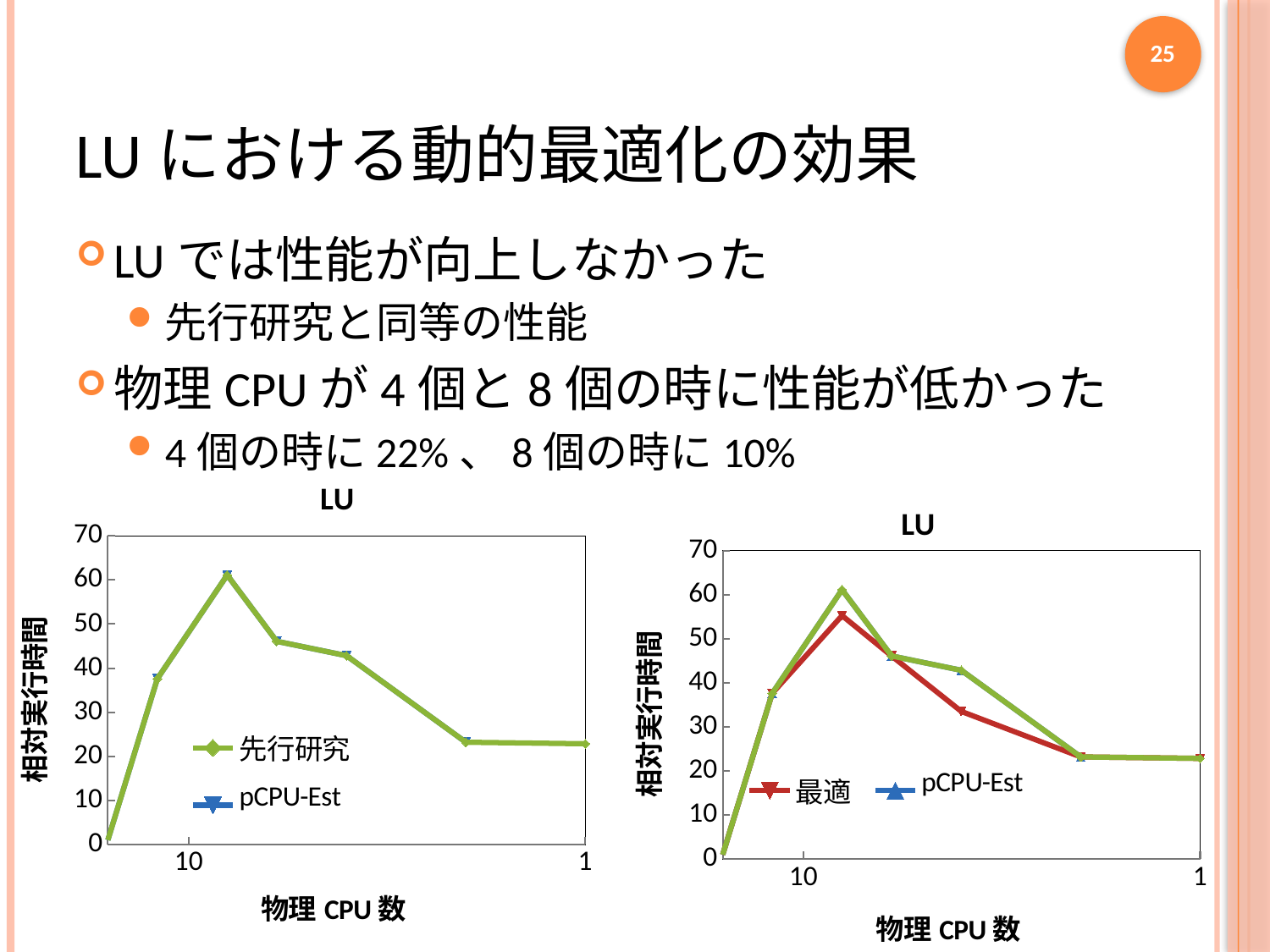
How many series does the legend of the right chart list? 2 What are the two series named in the legend of the right chart? 最適 and pCPU-Est How many series does the legend of the left chart list? 2 What kind of chart is the right chart on the slide? line chart In the left chart, after reaching their peak, do the values of the series rise or fall as the x axis moves toward 1? fall In the right chart, at the peak of the curves, which series has the larger value, 最適 or pCPU-Est? pCPU-Est In the left chart, is the highest value of the pCPU-Est series greater or less than 50? greater In the right chart, is the lowest value of the 最適 series greater or less than 10? less In the right chart, is the peak value of the 最適 series greater or less than 50? greater What kind of chart is the left chart on the slide? line chart What are the two series named in the legend of the left chart? 先行研究 and pCPU-Est